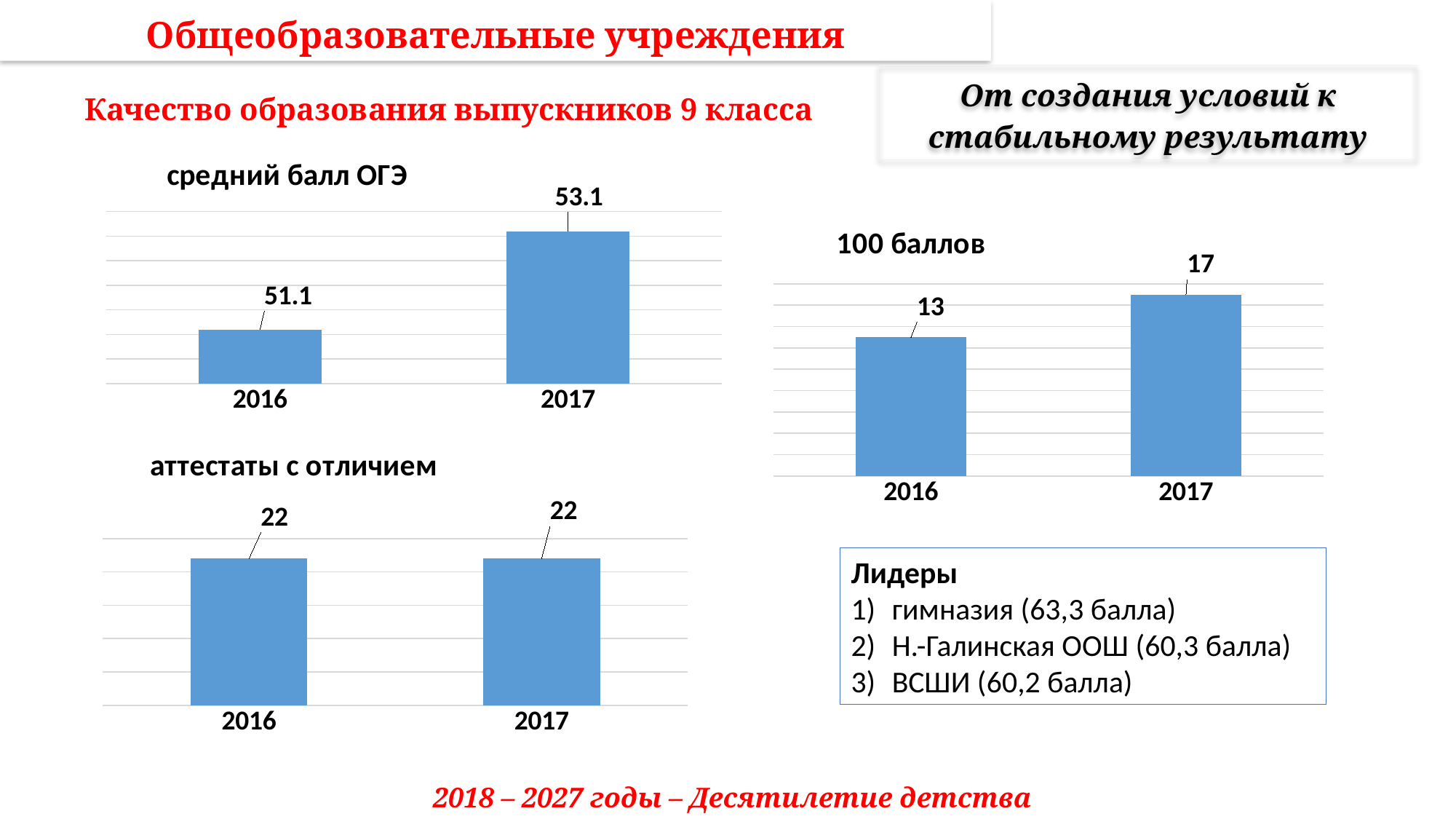
In the chart titled "100 баллов", which year has the lower value? 2016 In the chart titled "100 баллов", what is the value for 2017? 17 In the chart titled "аттестаты с отличием", what is the value for 2016? 22 In the chart titled "средний балл ОГЭ", what is the value for 2016? 51.1 In the chart titled "100 баллов", by how much does the 2017 value exceed the 2016 value? 4 What kind of chart is the chart titled "средний балл ОГЭ"? bar chart In the chart titled "аттестаты с отличием", do the values rise, fall or stay the same from 2016 to 2017? stay the same In the chart titled "средний балл ОГЭ", which year has the higher value? 2017 How many categories are shown on the x axis of the chart titled "100 баллов"? 2 In the chart titled "средний балл ОГЭ", what is the value for 2017? 53.1 In the chart titled "100 баллов", what is the value for 2016? 13 In the chart titled "средний балл ОГЭ", what is the difference between the 2017 and 2016 values? 2.0